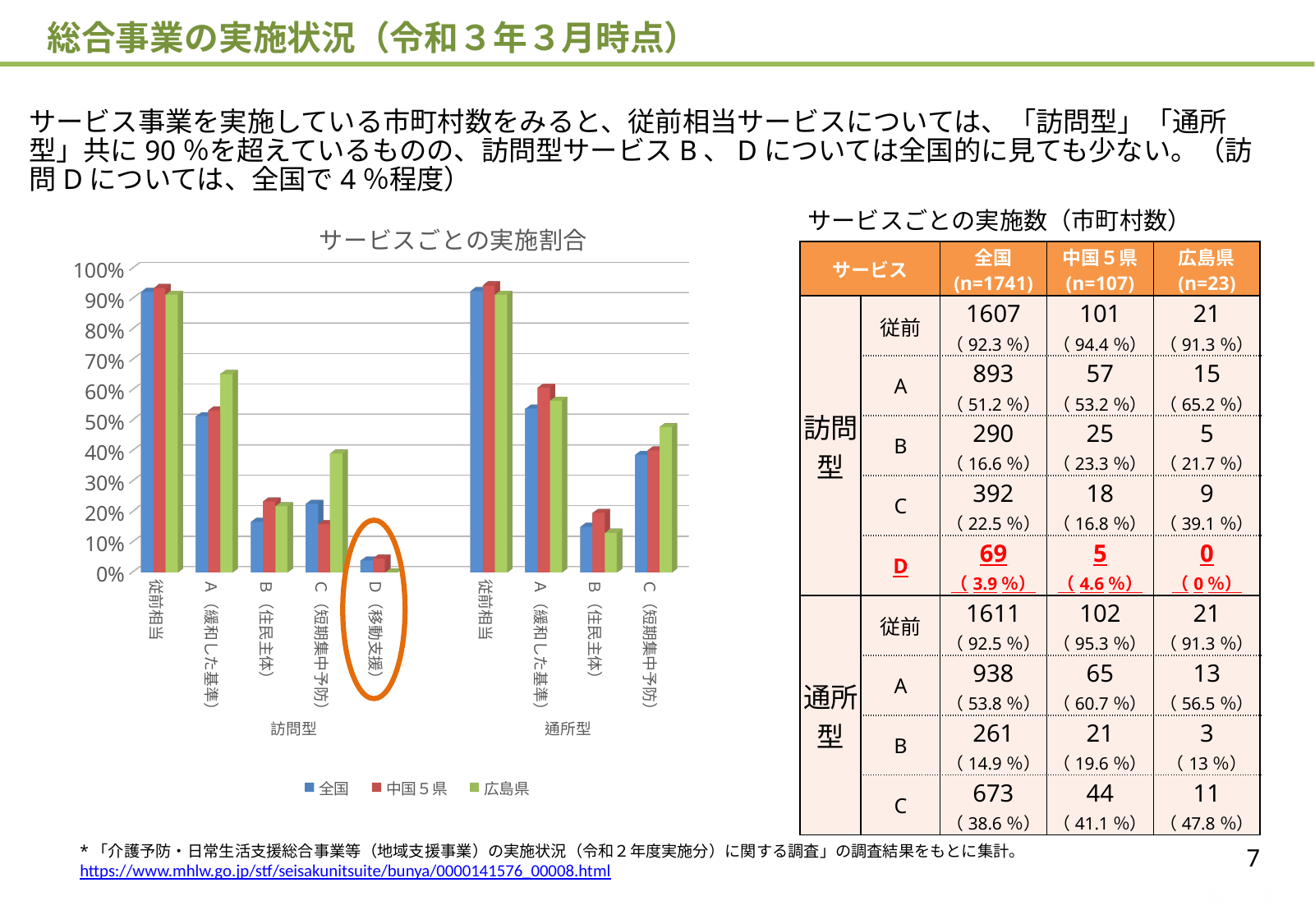
In the 「サービスごとの実施割合」 chart, is the 広島県 value for 通所型 C（短期集中予防） greater or less than 40%? greater Which category in the 「サービスごとの実施割合」 chart is circled in orange? 訪問型 D（移動支援） In the 「サービスごとの実施割合」 chart, is the 全国 value for 訪問型 B（住民主体） greater or less than 20%? less In the 「サービスごとの実施割合」 chart, for 訪問型 A（緩和した基準）, which is larger: 全国 or 広島県? 広島県 In the 「サービスごとの実施割合」 chart, is the 広島県 value for 訪問型 C（短期集中予防） greater or less than 30%? greater In the 「サービスごとの実施割合」 chart, for 通所型 B（住民主体）, which is larger: 中国５県 or 広島県? 中国５県 In the 「サービスごとの実施割合」 chart, which series has the lowest value for 訪問型 D（移動支援）? 広島県 In the 「サービスごとの実施割合」 chart, which colour represents the 全国 series? blue What kind of chart is 「サービスごとの実施割合」? bar chart How many categories are plotted along the x axis of the 「サービスごとの実施割合」 chart? 9 In the 「サービスごとの実施割合」 chart, which 訪問型 category has the lowest 全国 value? D（移動支援） How many series does the legend of the 「サービスごとの実施割合」 chart list? 3